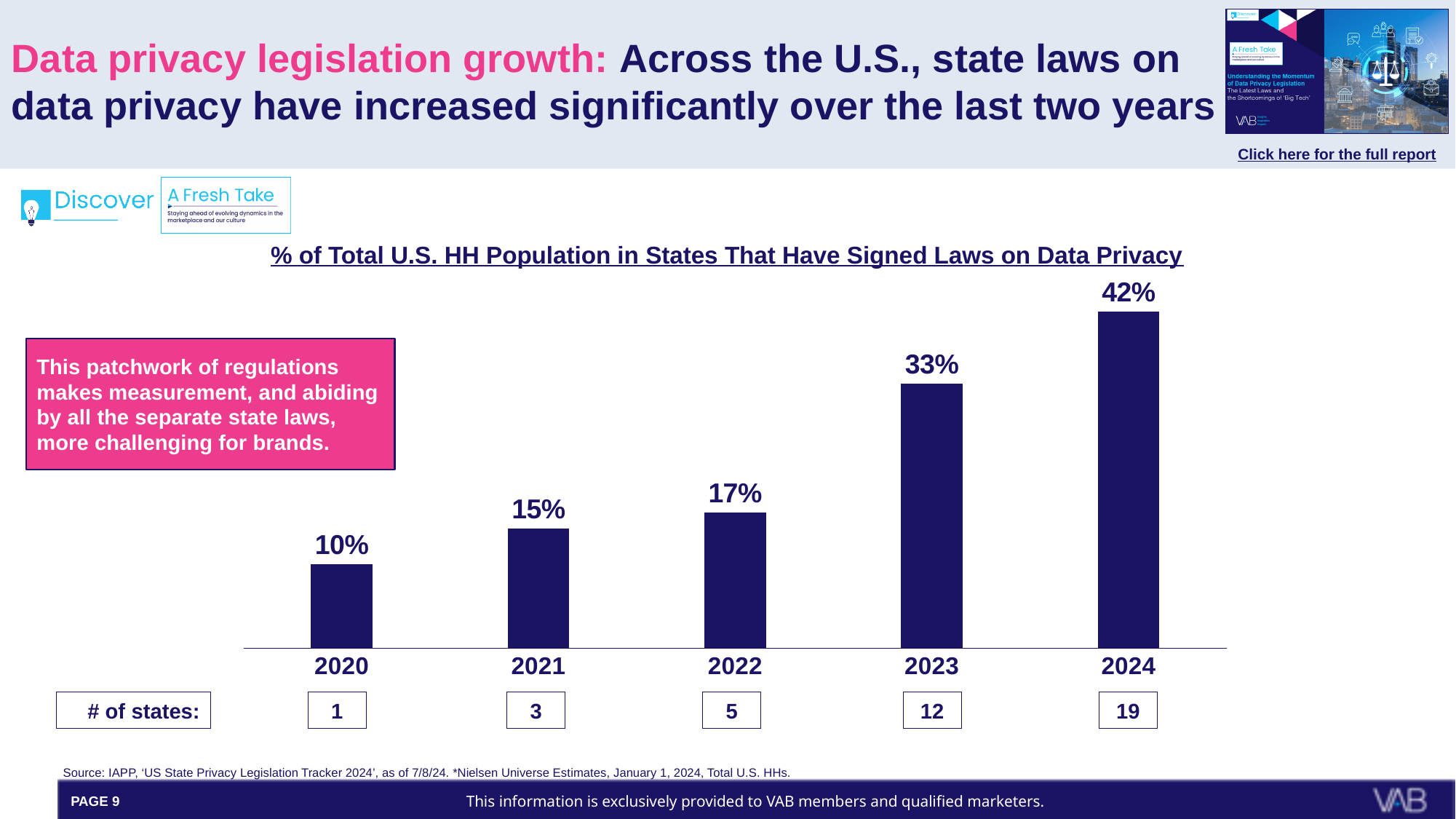
What is the value shown for 2024? 42% What percentage of total U.S. HH population was in states that had signed data privacy laws in 2022? 17% Which year has the lowest percentage shown in the chart? 2020 How many years are shown on the x axis of the chart? 5 What is the difference in percentage points between 2024 and 2020? 32 Do the values rise or fall from 2020 to 2024? Rise What kind of chart is used to show the % of total U.S. HH population in states with signed data privacy laws? Bar chart Which year has the highest percentage of U.S. HH population in states with signed data privacy laws? 2024 What is the value shown for 2020? 10% Which year has a larger value, 2021 or 2023? 2023 According to the row below the chart, how many states had signed data privacy laws in 2023? 12 What is the difference in percentage points between 2023 and 2022? 16